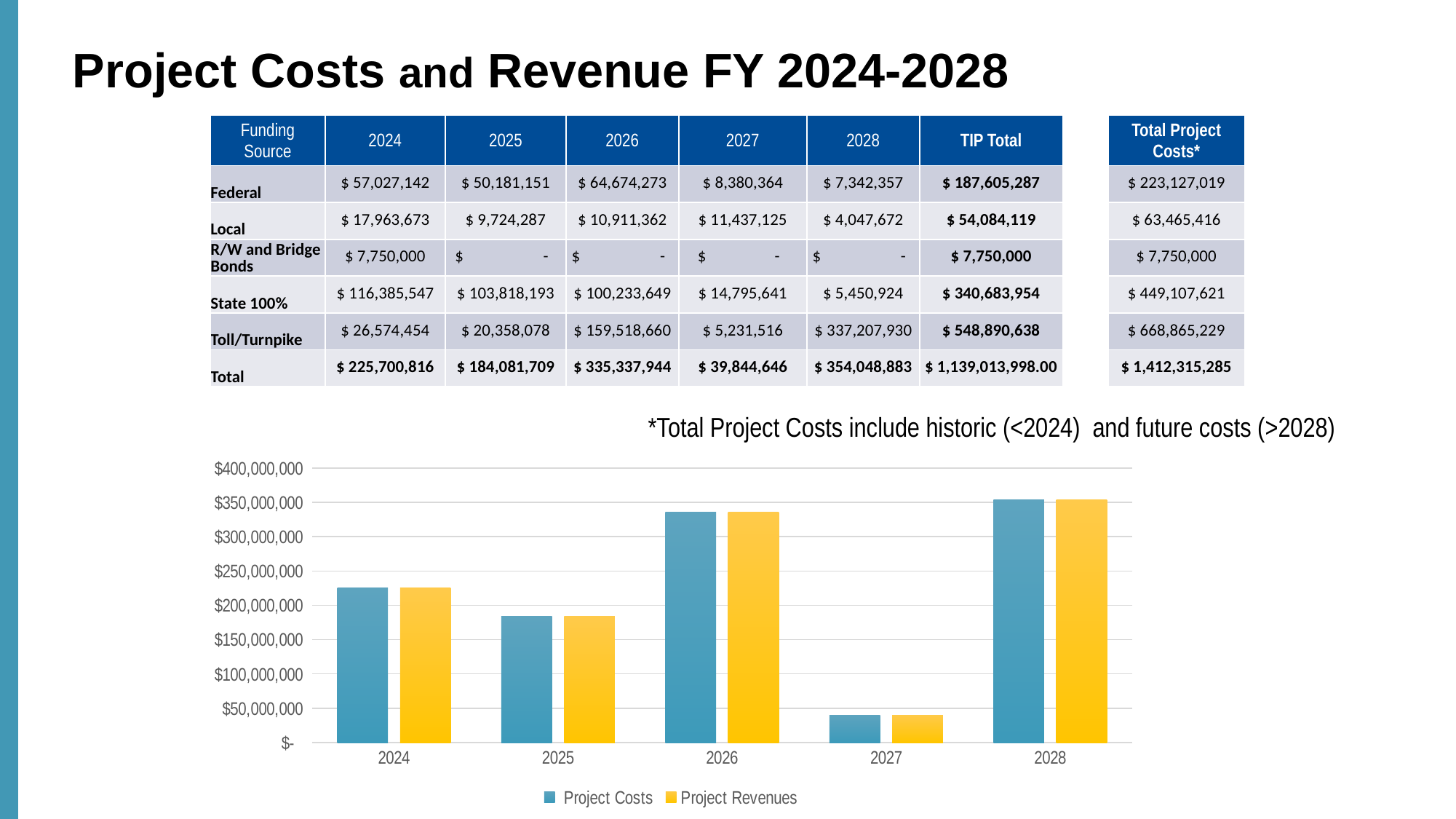
What colour are the Project Revenues bars in the chart? yellow Is the Project Revenues value for 2025 greater or less than $200,000,000? less How many series does the chart legend list? 2 Do the Project Costs bars rise or fall from 2026 to 2027? fall Which year has the larger Project Costs bar, 2024 or 2025? 2024 Is the Project Costs value for 2024 greater or less than $200,000,000? greater Is the Project Costs value for 2026 greater or less than $300,000,000? greater Which year has the lowest Project Revenues bar in the chart? 2027 What kind of chart is shown on the slide? bar chart How many years are shown on the x axis of the chart? 5 Which year has the highest Project Costs bar in the chart? 2028